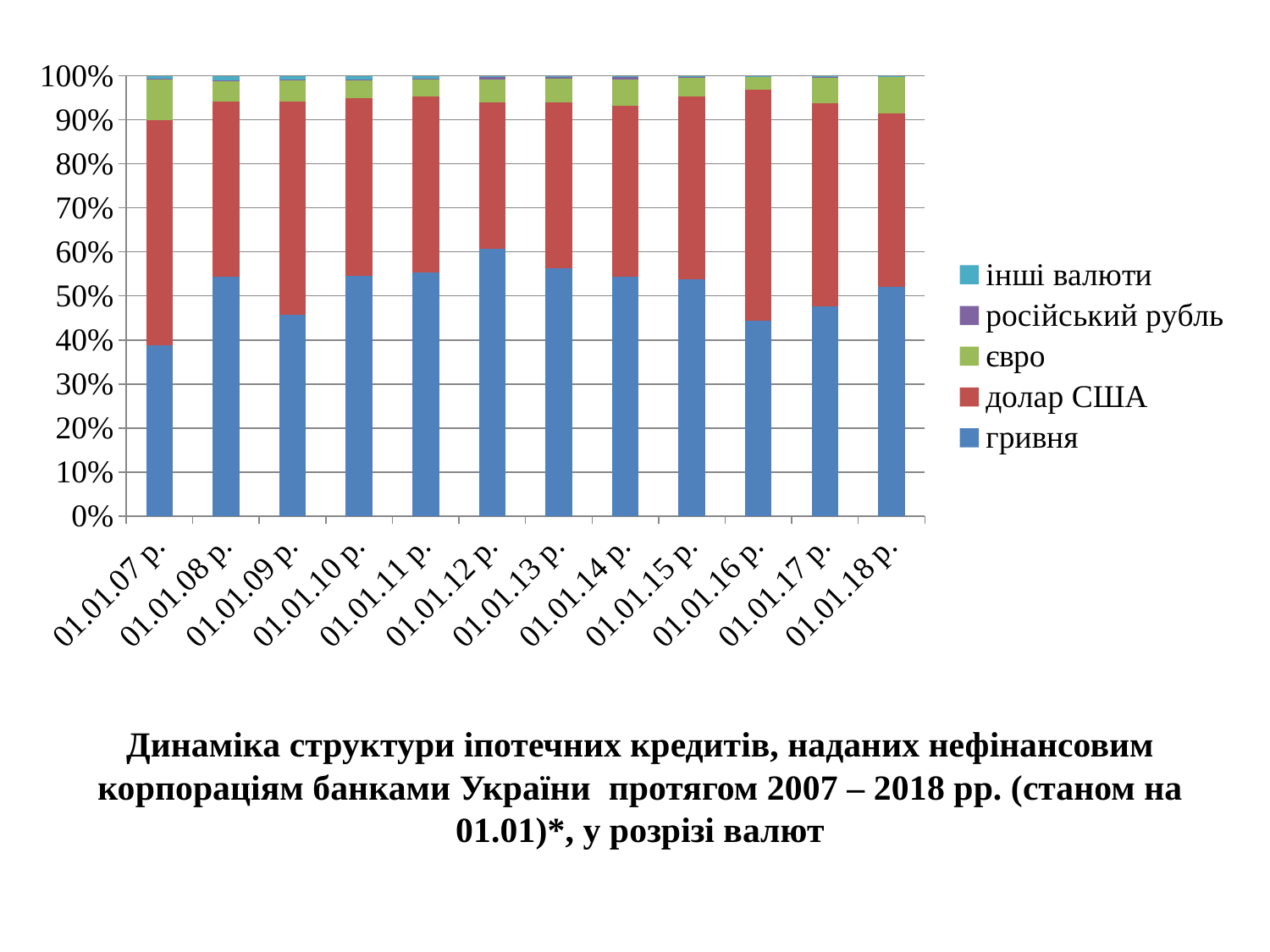
How many series does the legend list? 5 What kind of chart is shown on the slide? stacked bar chart What is the total of each stacked bar in the chart? 100% Is the share of гривня for 01.01.12 р. greater or less than 50%? greater Is the share of гривня for 01.01.16 р. greater or less than 50%? less Which series is shown at the bottom of each stacked bar? гривня On which date is the share of гривня the highest? 01.01.12 р. Is the share of гривня for 01.01.07 р. greater or less than 50%? less On which date is the share of гривня the lowest? 01.01.07 р. Which date has a larger share of гривня, 01.01.08 р. or 01.01.09 р.? 01.01.08 р. How many dates (categories) are shown on the x axis? 12 Which colour represents долар США in the legend? red